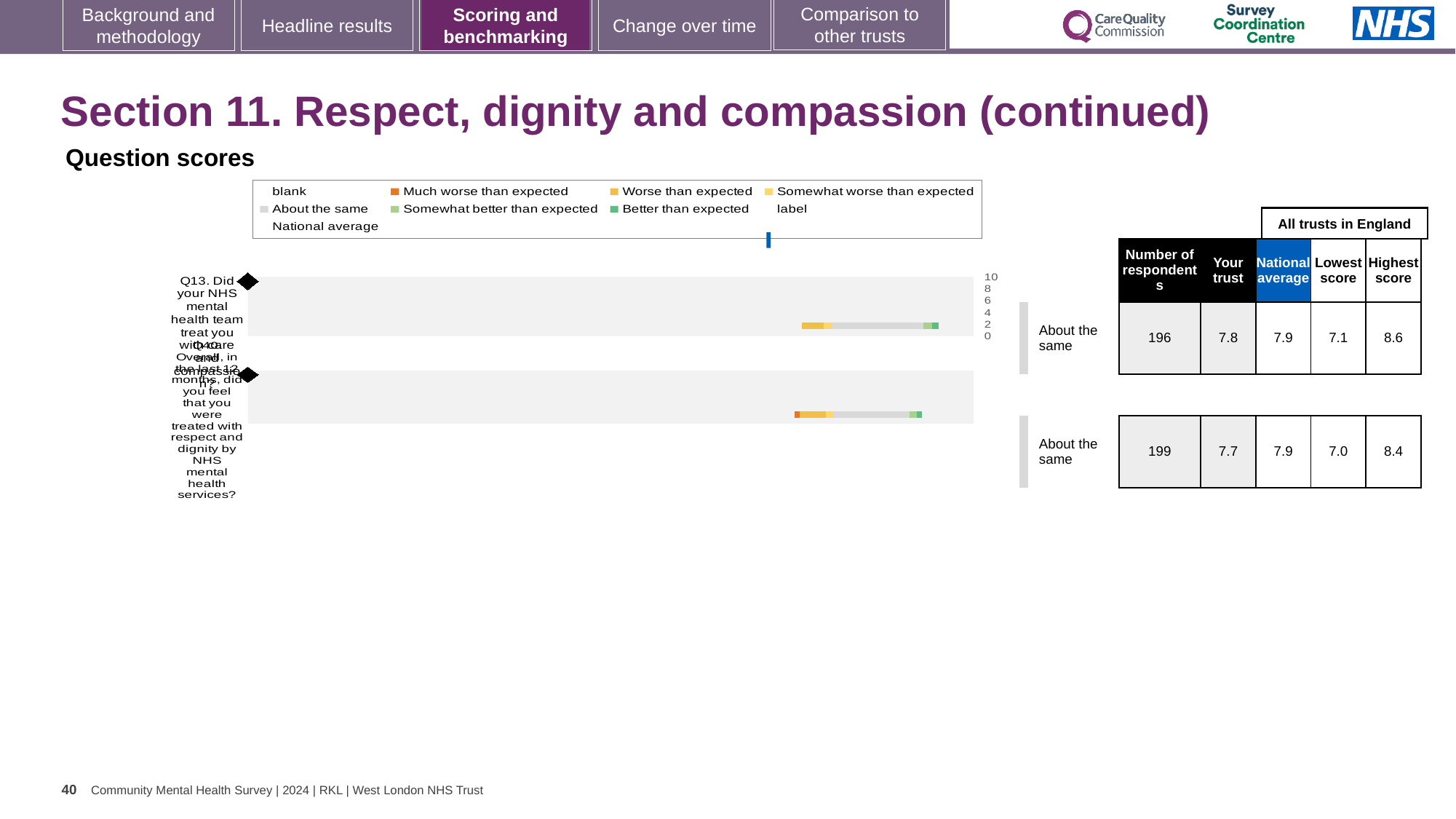
Which legend entry is shown with a dark orange colour? Much worse than expected How many questions (bars) are plotted in the chart? 2 What is the difference between the highest score and the lowest score for Q40 in the table? 1.4 According to the table, what is the number of respondents for Q40? 199 According to the table, what is the lowest score across all trusts in England for Q40? 7.0 According to the table, what is the 'Your trust' score for Q13? 7.8 According to the table, what is the highest score across all trusts in England for Q13? 8.6 What benchmark category label is shown next to the bar for Q13? About the same What kind of chart is shown under 'Question scores'? bar chart According to the table, what is the 'Your trust' score for Q40? 7.7 Which question has the higher 'Your trust' score in the table, Q13 or Q40? Q13 According to the table, what is the number of respondents for Q13? 196